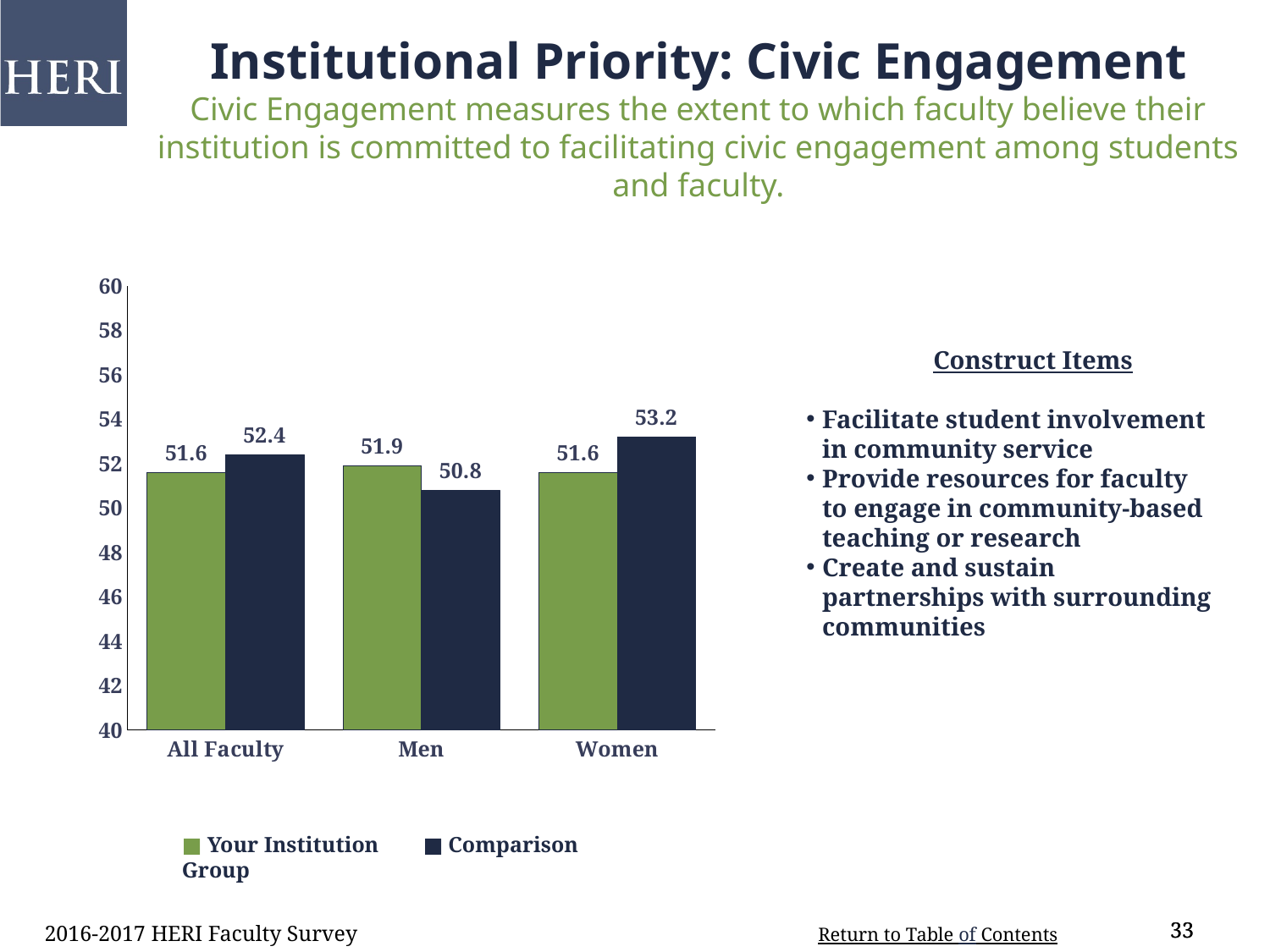
How many series does the legend list? 2 For Men, which is larger: Your Institution or Comparison Group? Your Institution What is the value for Your Institution in the Men category? 51.9 What is the value for Your Institution in the All Faculty category? 51.6 Which category has the lowest Comparison Group value? Men How many categories are shown on the x axis? 3 What is the difference between the Comparison Group and Your Institution values for Women? 1.6 What is the Comparison Group value for Women? 53.2 What kind of chart is shown on the slide? bar chart What is the Comparison Group value for Men? 50.8 Which category has the highest Comparison Group value? Women Is the Comparison Group value for All Faculty greater or less than 52? greater